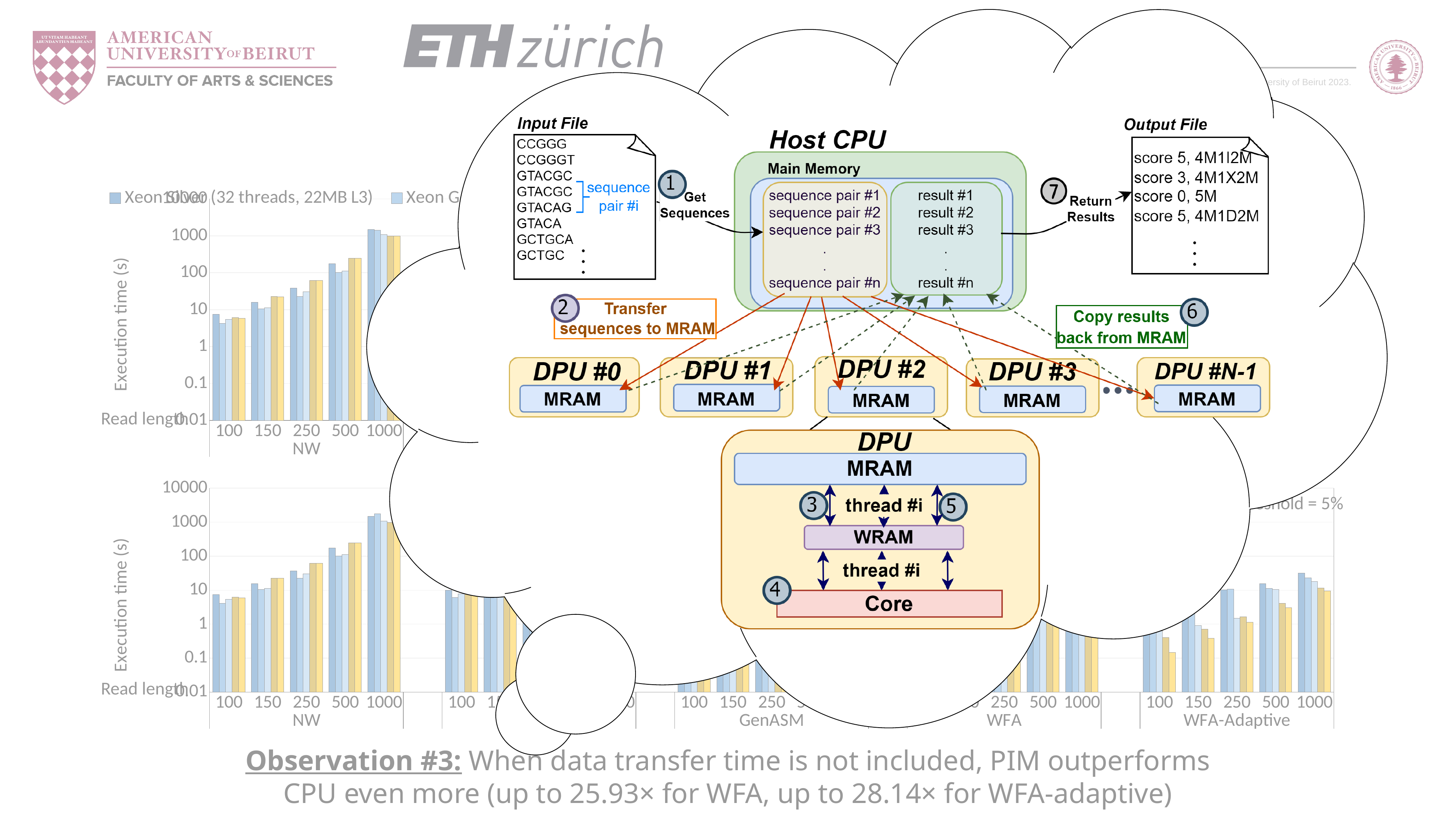
In the top-left chart, how many read-length categories are shown for NW? 5 What is the y-axis label of the top-left chart? Execution time (s) What is the x-axis label of the bottom chart? Read length What kind of chart is the top-left chart on the slide? bar chart In the top-left chart, which NW read length has the lowest execution time? 100 In the bottom chart, is the execution time for WFA-Adaptive at read length 100 greater or less than 10 seconds? less In the top-left chart, does execution time for NW rise or fall as read length increases from 100 to 1000? rise In the top-left chart, which NW read length has the highest execution time? 1000 In the top-left chart, is the execution time for NW at read length 250 greater or less than 10 seconds? greater In the top-left chart, is the execution time for NW at read length 100 greater or less than 10 seconds? less